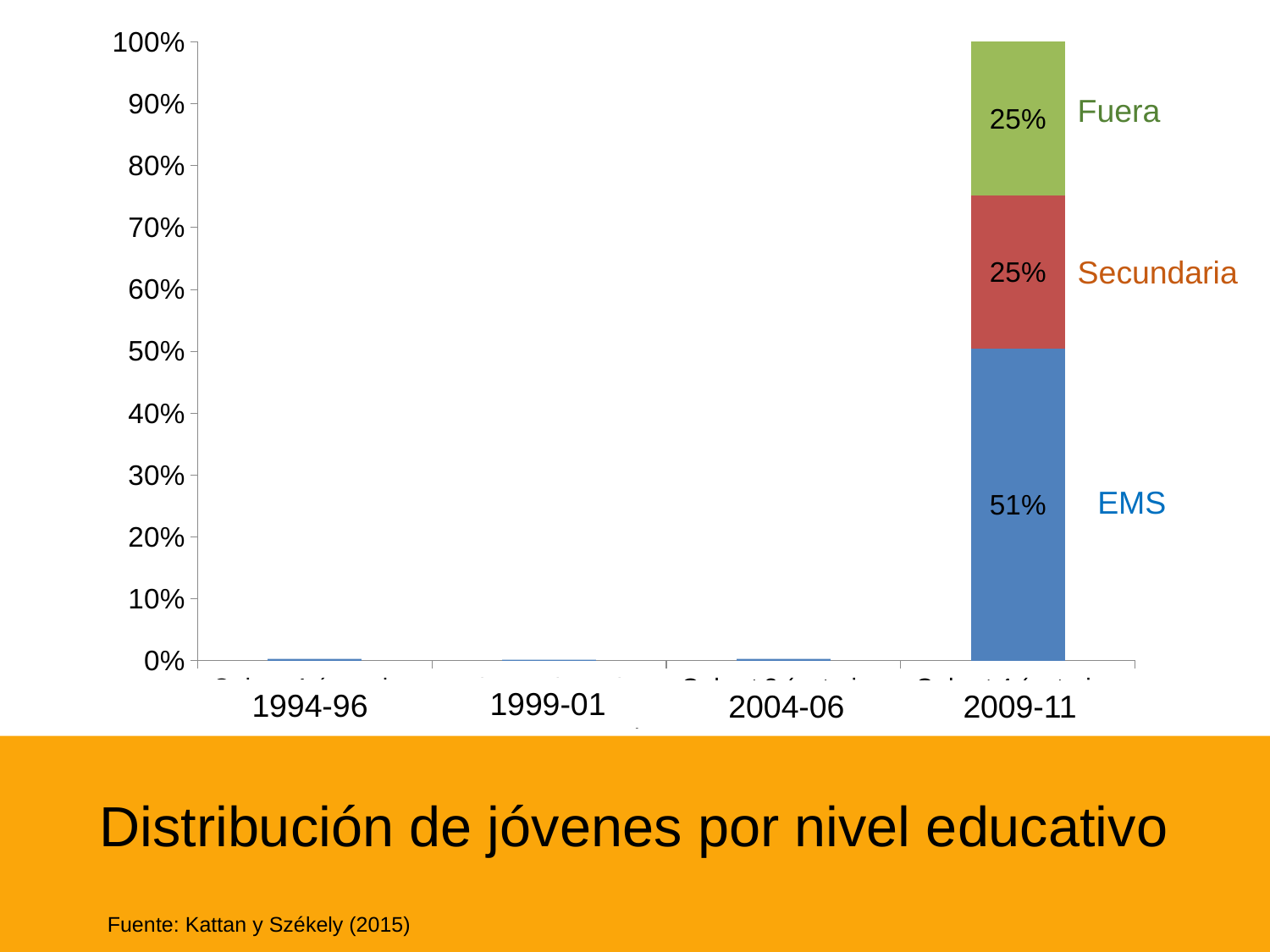
How many period categories are shown on the x axis? 4 What is the difference between the EMS and Secundaria values in the 2009-11 bar? 26 percentage points What is the value for Secundaria in the 2009-11 bar? 25% What source is cited for the chart? Kattan y Székely (2015) How many segments make up the 2009-11 stacked bar? 3 Is the value for EMS in 2009-11 greater or less than 40%? greater What is the value for EMS in the 2009-11 bar? 51% Which segment of the 2009-11 bar is the largest? EMS What is the value for Fuera in the 2009-11 bar? 25% Which is larger in the 2009-11 bar, EMS or Secundaria? EMS What is the title of the chart? Distribución de jóvenes por nivel educativo What kind of chart is shown on the slide? Stacked bar chart